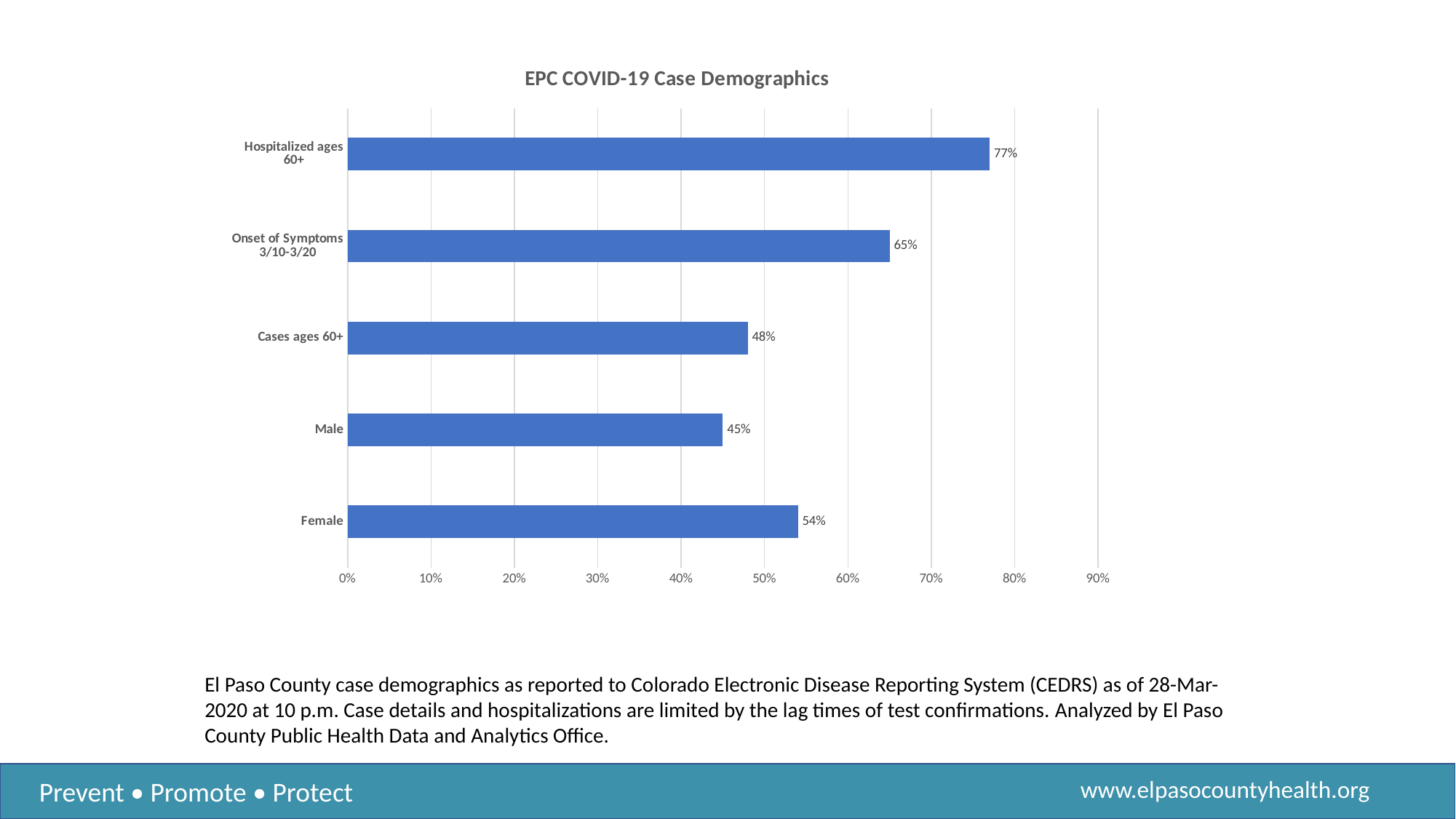
What is the value for Cases ages 60+? 48% What is the value for Male? 45% Which category has the lowest value? Male Which category has the highest value? Hospitalized ages 60+ What is the value for Hospitalized ages 60+? 77% What kind of chart is shown on the slide? Bar chart What is the title of the chart? EPC COVID-19 Case Demographics How many categories are shown in the chart? 5 What is the value for Female? 54% Which is larger, the value for Onset of Symptoms 3/10-3/20 or the value for Cases ages 60+? Onset of Symptoms 3/10-3/20 What is the value for Onset of Symptoms 3/10-3/20? 65% What is the difference between the Female and Male values? 9%